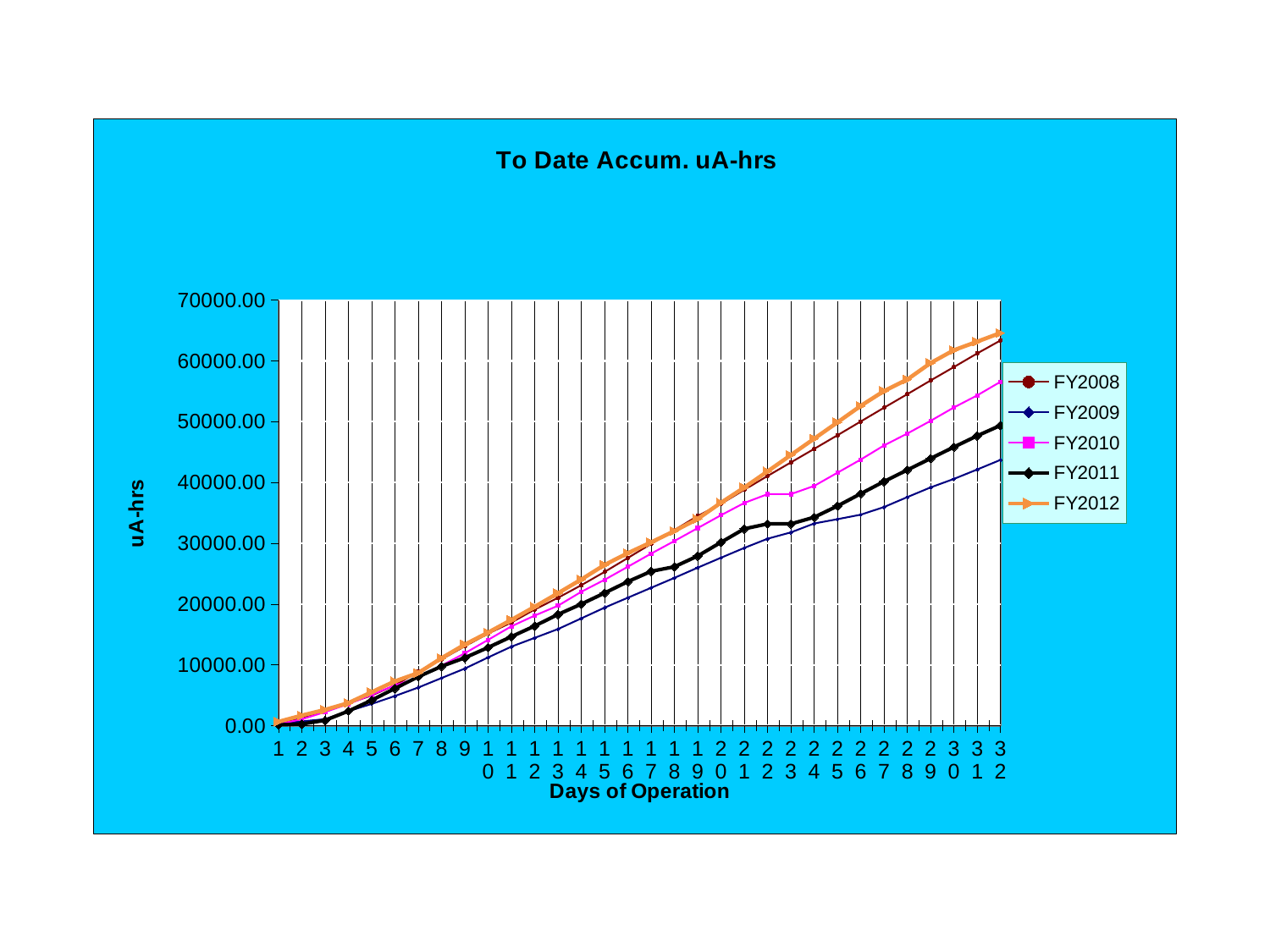
What is the title of the chart? To Date Accum. uA-hrs What kind of chart is shown on the slide? line chart How many series does the legend list? 5 Which series has the lowest value at day 32? FY2009 How many days of operation are shown on the x axis? 32 Do the values for FY2012 rise or fall as the days of operation increase? rise Is the value for FY2009 at day 20 greater or less than 30000.00? less Is the value for FY2012 at day 32 greater or less than 60000.00? greater At day 32, which is larger, the value for FY2010 or the value for FY2009? FY2010 What is the label of the y axis? uA-hrs Is the value for FY2010 at day 32 greater or less than 50000.00? greater